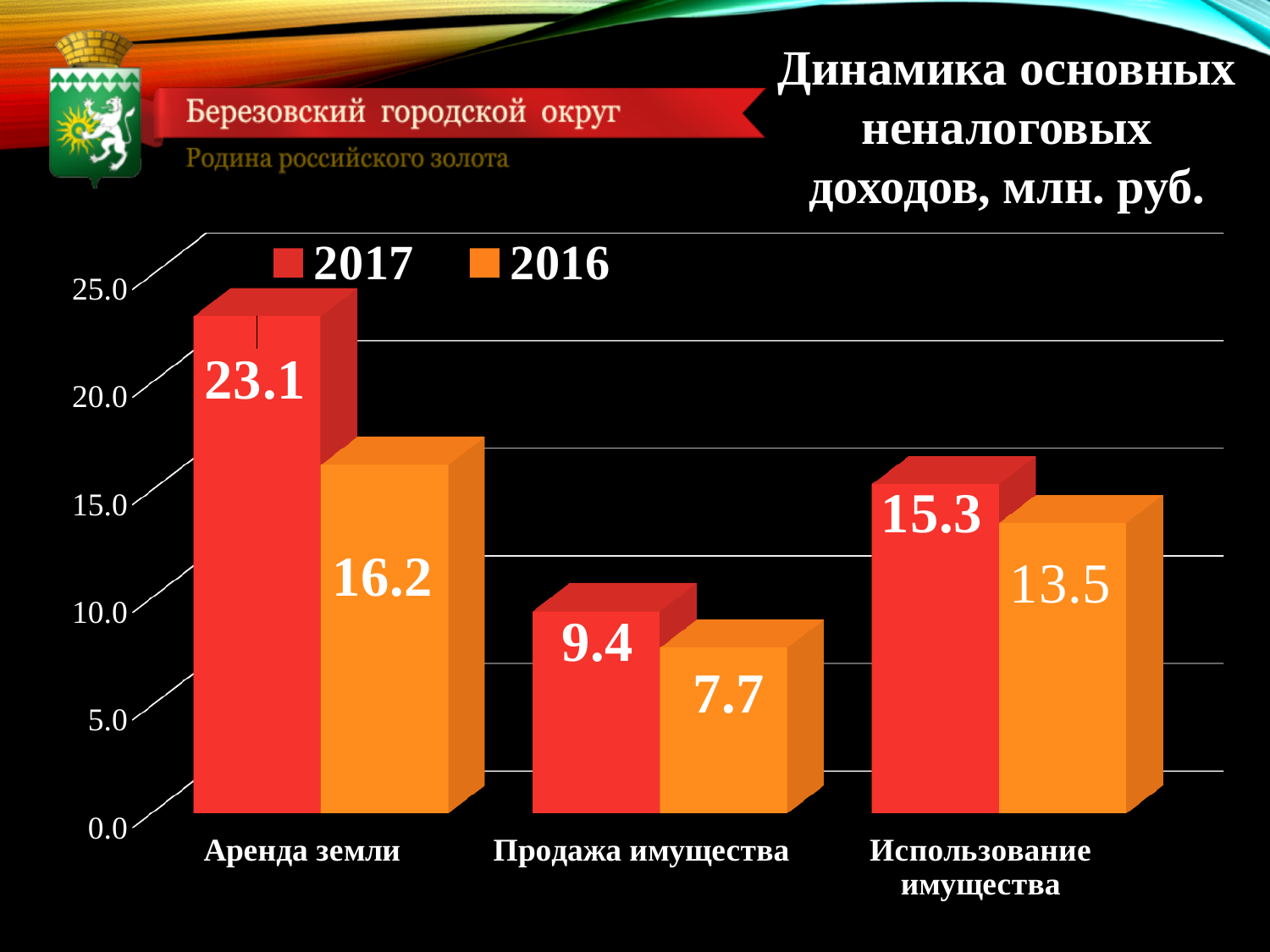
What is the difference between the 2017 and 2016 values for Аренда земли? 6.9 Which is larger for Продажа имущества, the 2017 value or the 2016 value? 2017 What is the 2016 value for Использование имущества? 13.5 What is the difference between the 2017 and 2016 values for Использование имущества? 1.8 What is the 2017 value for Аренда земли? 23.1 What is the 2016 value for Продажа имущества? 7.7 How many categories are shown on the x axis? 3 What kind of chart is shown on the slide? bar chart How many series does the legend list? 2 Is the 2017 value for Использование имущества greater or less than 20.0? less Which category has the lowest 2016 value? Продажа имущества Which category has the highest 2017 value? Аренда земли